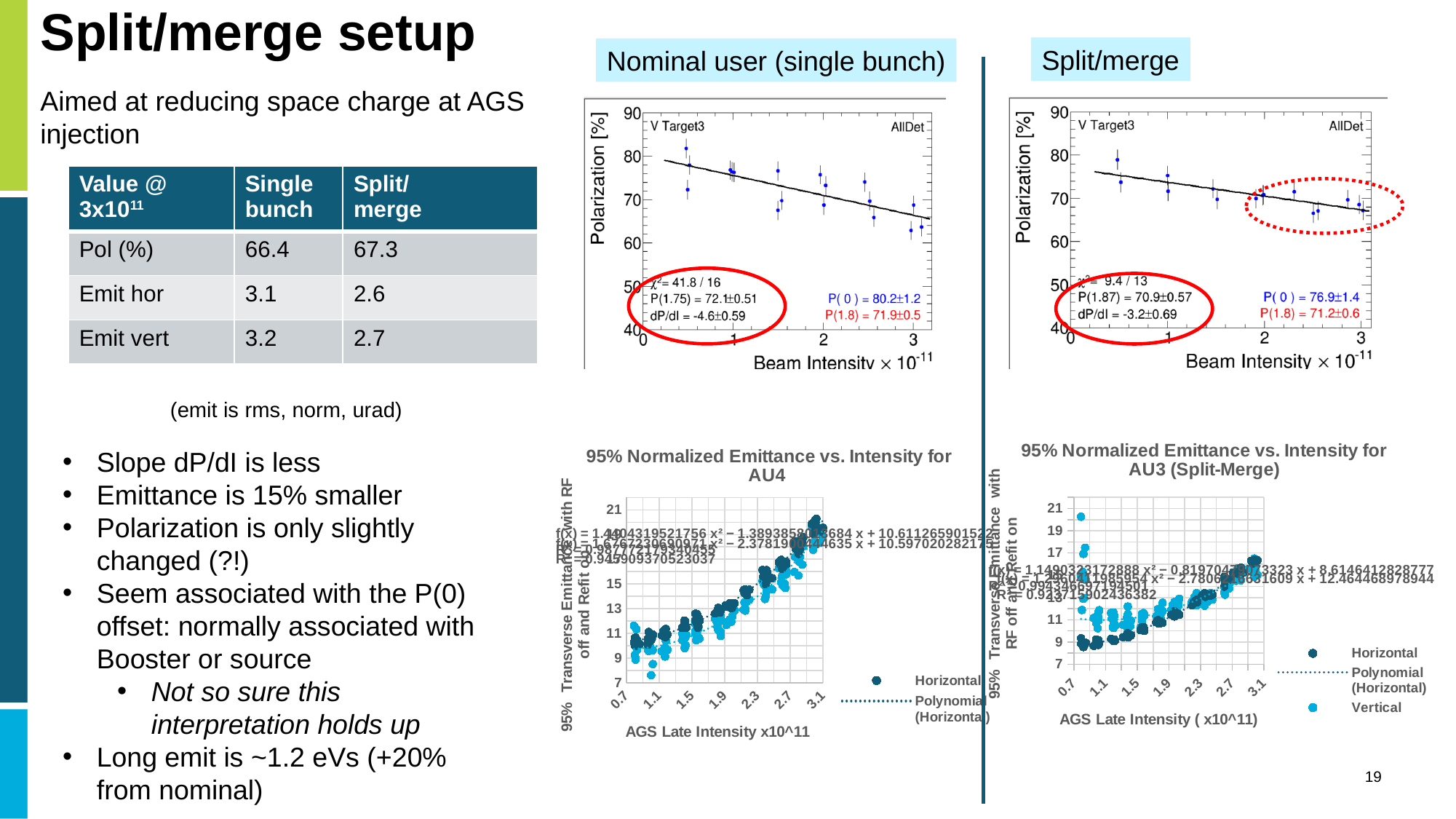
In the top-left polarization chart (Nominal user, single bunch), what is the printed slope dP/dI? -4.6±0.59 In the bottom-left chart for AU4, how many entries does the legend list? 2 Which chart shows the larger printed P(1.8) value, the top-left Nominal user chart or the top-right Split/merge chart? top-left Nominal user chart What is the x-axis label of the bottom-left chart for AU4? AGS Late Intensity x10^11 In the bottom-right chart titled '95% Normalized Emittance vs. Intensity for AU3 (Split-Merge)', how many series does the legend list? 3 In the bottom-right chart for AU3 (Split-Merge), do the emittance values rise or fall as intensity increases from about 1.5 to 3.1? rise In the bottom-left chart for AU4, do the emittance values rise or fall as AGS Late Intensity increases along the x axis? rise What is the y-axis label of the top-right polarization chart (Split/merge)? Polarization [%] In the top-right polarization chart (Split/merge), what is the printed value of P(0)? 76.9±1.4 In the top-right polarization chart (Split/merge), what is the printed slope dP/dI? -3.2±0.69 What kind of chart is the bottom-left chart titled '95% Normalized Emittance vs. Intensity for AU4'? scatter chart In the top-left polarization chart (Nominal user, single bunch), what is the printed value of P(0)? 80.2±1.2